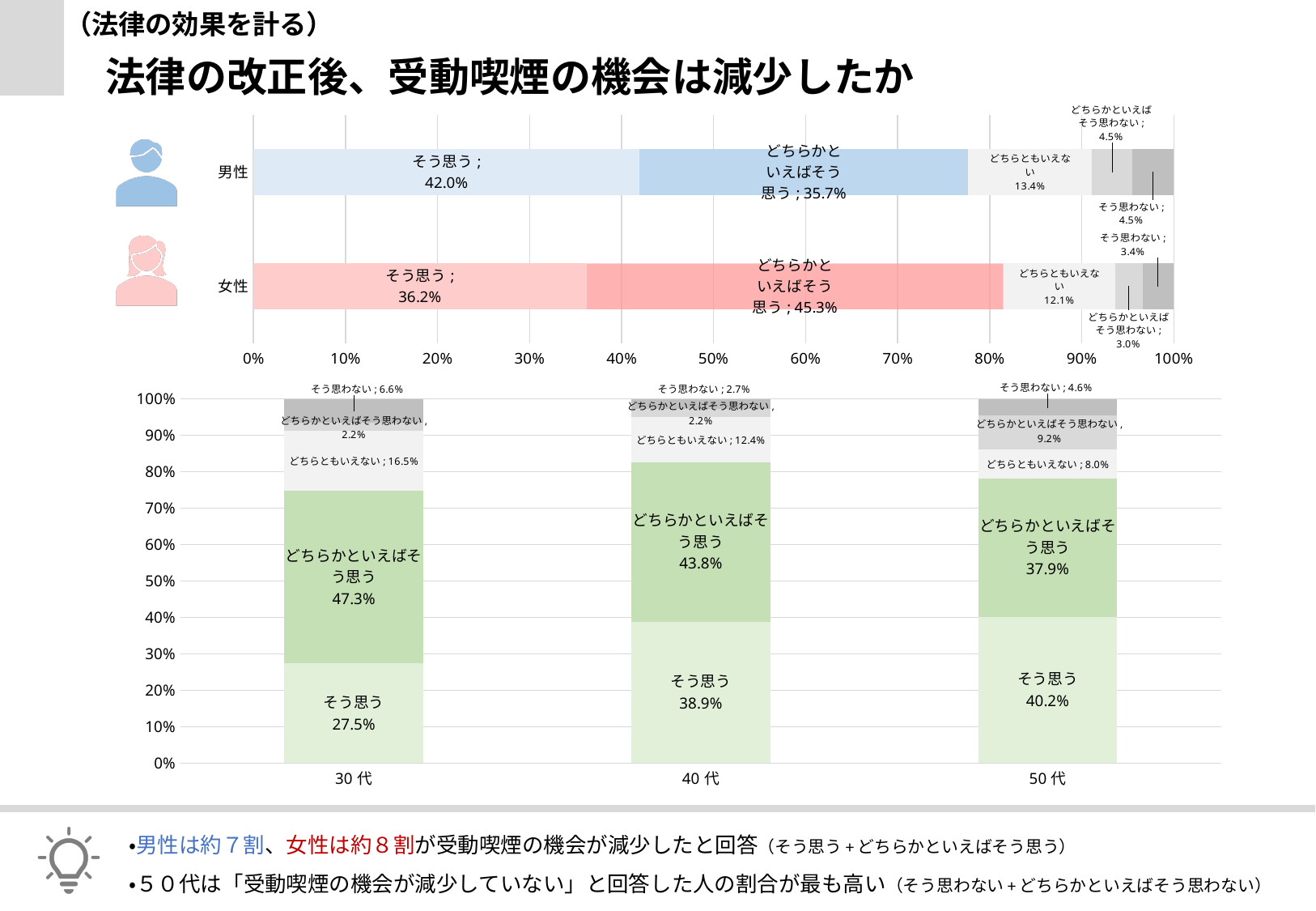
In the top chart (男性/女性), which has the larger どちらともいえない value, 男性 or 女性? 男性 In the bottom chart (30代/40代/50代), how many age groups are shown on the x axis? 3 In the top chart (男性/女性), what is the value of どちらかといえばそう思う for 女性? 45.3% In the top chart (男性/女性), what is the combined share of そう思う and どちらかといえばそう思う for 女性? 81.5% In the top chart (男性/女性), what is the difference between the そう思う values for 男性 and 女性? 5.8% In the bottom chart (30代/40代/50代), which age group has the highest どちらかといえばそう思う value? 30代 In the bottom chart (30代/40代/50代), what is the value of そう思う for 40代? 38.9% In the top chart (男性/女性), what is the value of そう思う for 男性? 42.0% In the bottom chart (30代/40代/50代), which age group has the lowest そう思う value? 30代 In the top chart (男性/女性), what type of chart is it? Stacked bar chart In the bottom chart (30代/40代/50代), what is the difference between the どちらともいえない values for 30代 and 50代? 8.5% In the bottom chart (30代/40代/50代), what is the value of どちらかといえばそう思わない for 50代? 9.2%